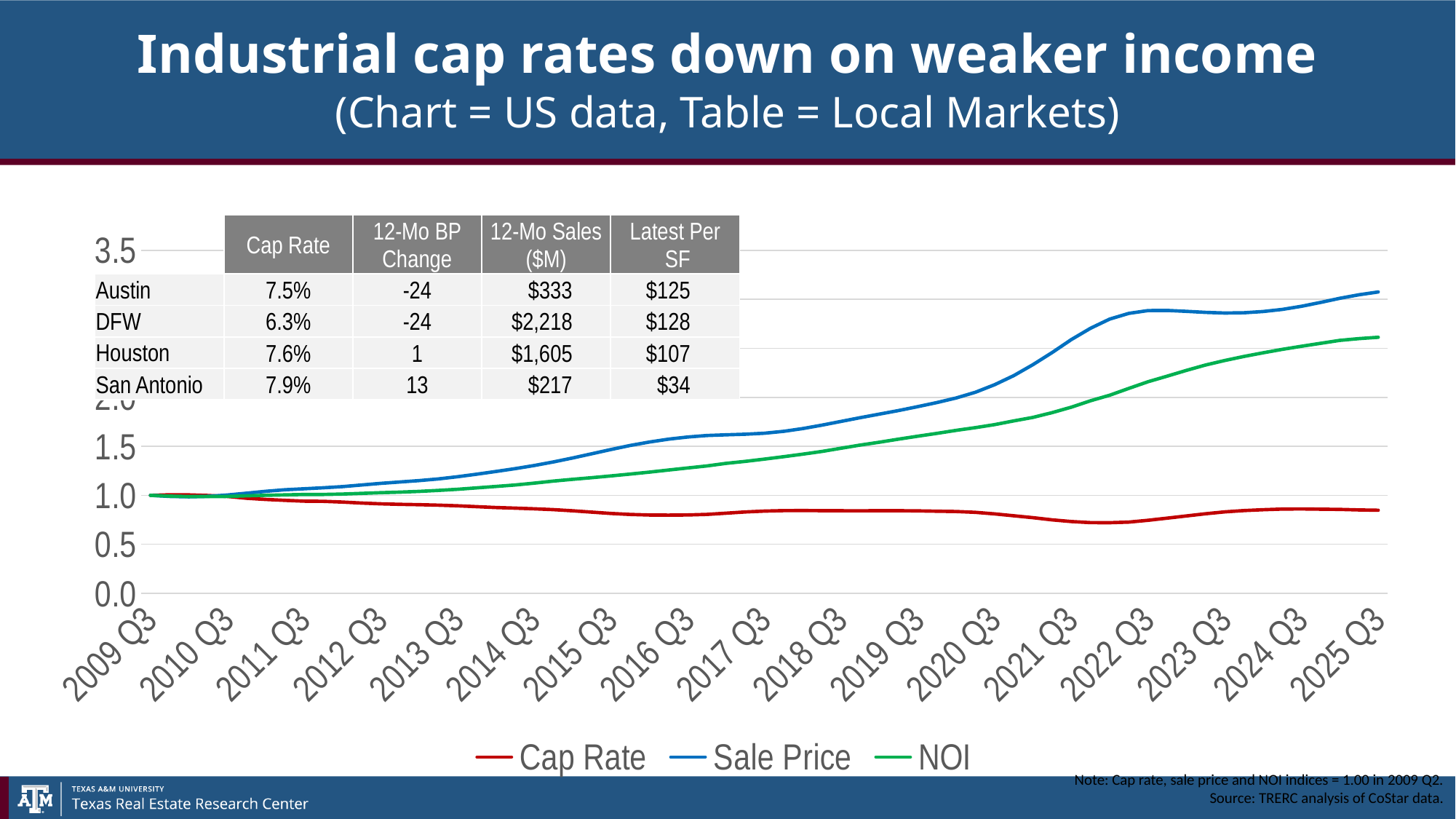
How many series does the chart's legend list? 3 What kind of chart is shown on the slide? line chart Is the Cap Rate value at 2025 Q3 greater or less than 1.0? less Is the NOI value at 2025 Q3 greater or less than 2.0? greater Is the Sale Price value at 2025 Q3 greater or less than 2.5? greater Does the Sale Price line rise or fall from 2009 Q3 to 2025 Q3? rise At 2020 Q3, which is larger: the NOI value or the Cap Rate value? NOI Which series has the lowest value at 2025 Q3? Cap Rate What colour is the Sale Price line in the chart? blue Does the NOI line rise or fall from 2009 Q3 to 2025 Q3? rise Which series has the highest value at 2025 Q3? Sale Price What are the three series named in the chart's legend? Cap Rate, Sale Price, NOI